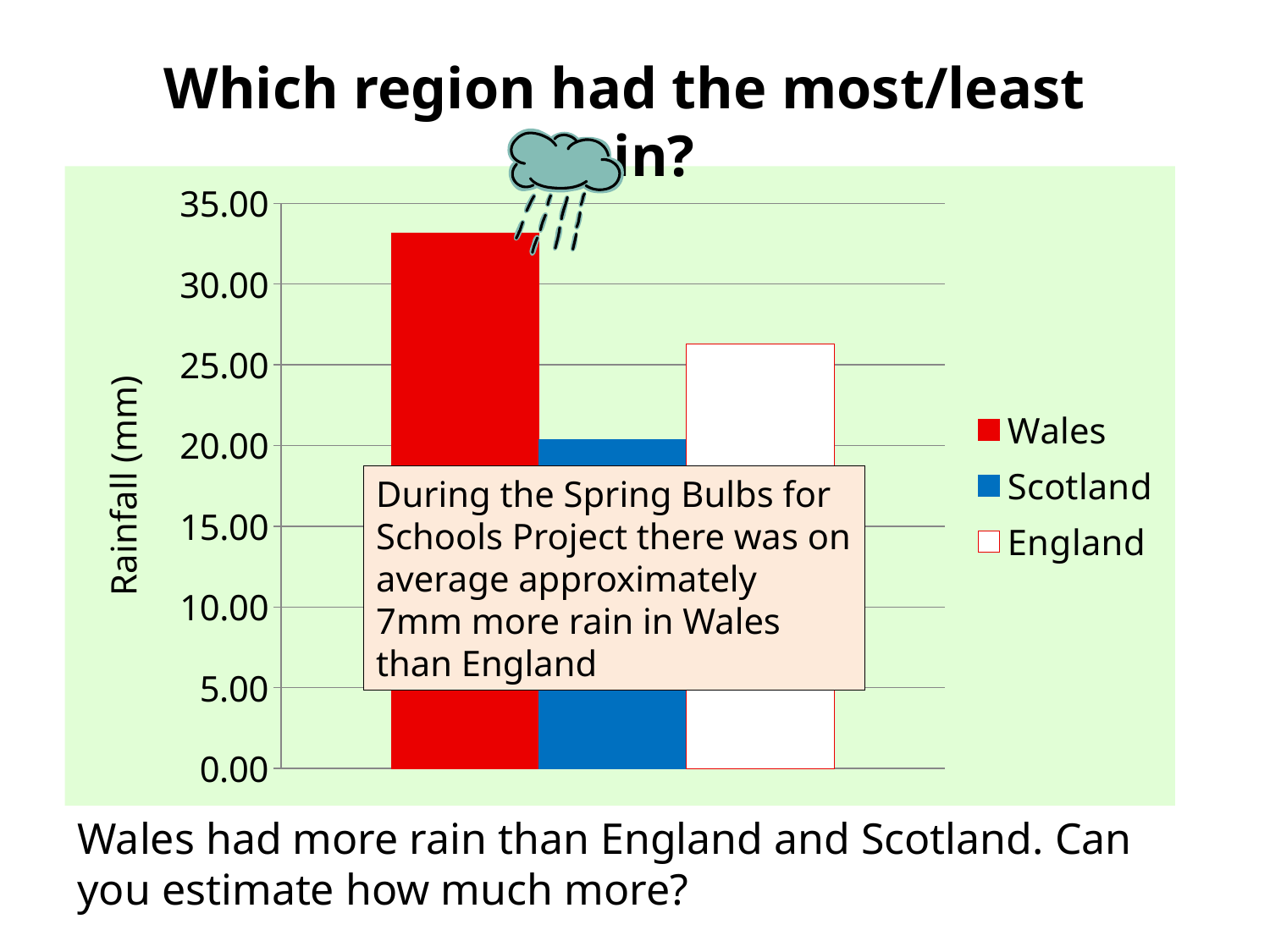
Is the value for Scotland greater or less than 25.00? less Is the value for England greater or less than 30.00? less Is the value for Wales greater or less than 30.00? greater What is the label on the vertical axis? Rainfall (mm) Which colour represents Wales in the legend? red Which has the larger rainfall value, England or Scotland? England How many series does the legend list? 3 Which region has the highest rainfall bar? Wales Which has the larger rainfall value, Wales or England? Wales What kind of chart is shown on the slide? bar chart Which region has the lowest rainfall bar? Scotland